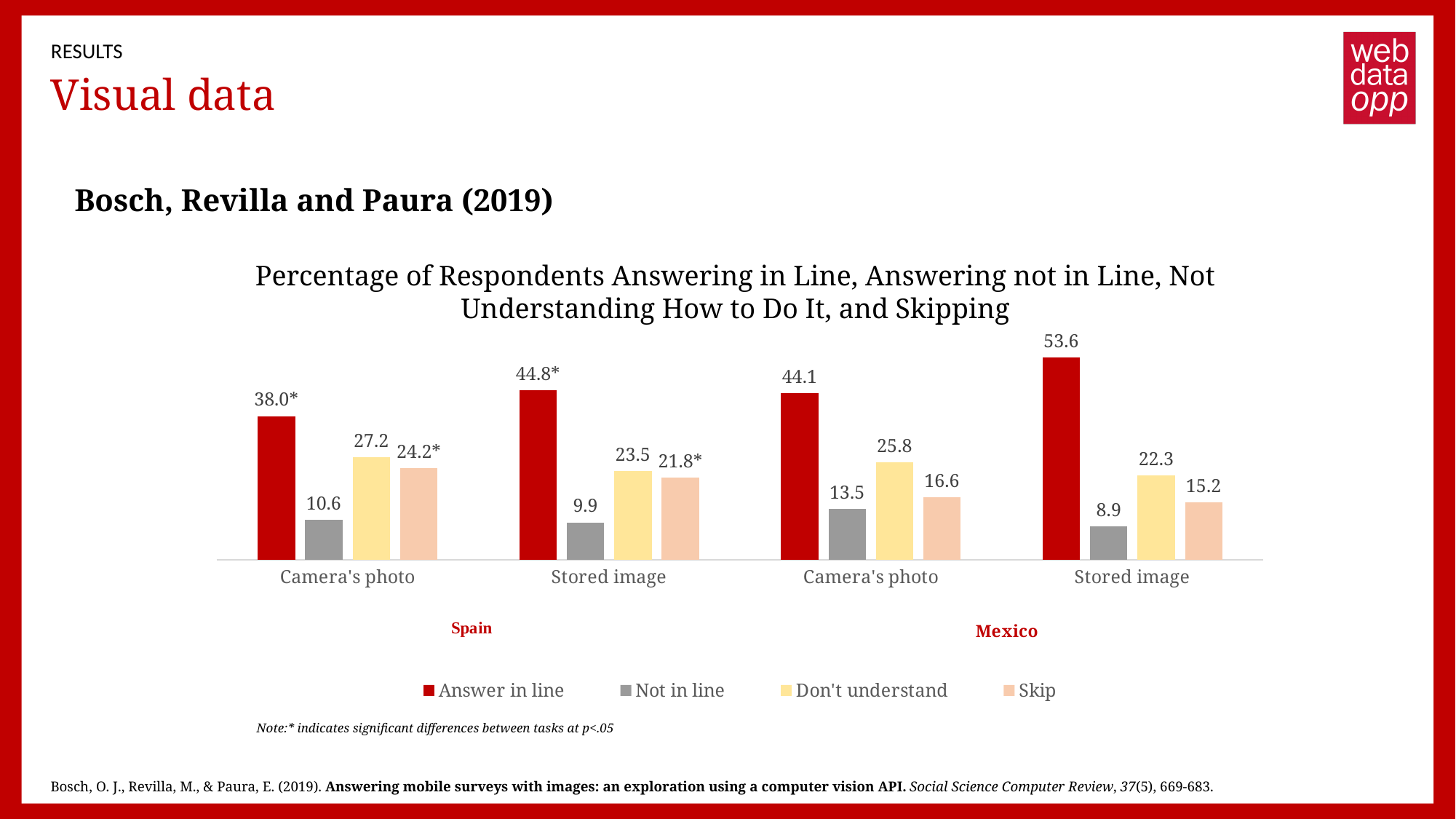
Which is larger: "Skip" for Camera's photo in Mexico or "Skip" for Stored image in Mexico? Camera's photo in Mexico What is the value for "Don't understand" for Camera's photo in Mexico? 25.8 What is the value for "Skip" for Stored image in Spain? 21.8* Which group has the lowest "Not in line" value? Stored image (Mexico) What colour are the "Answer in line" bars? Red What is the value for "Answer in line" for Stored image in Mexico? 53.6 What kind of chart is shown on the slide? Bar chart How many series does the legend list? 4 Which group has the highest "Answer in line" value? Stored image (Mexico) What is the value for "Not in line" for Camera's photo in Spain? 10.6 What is the difference between the "Answer in line" values for Stored image and Camera's photo in Spain? 6.8 How many category groups are shown on the x axis? 4